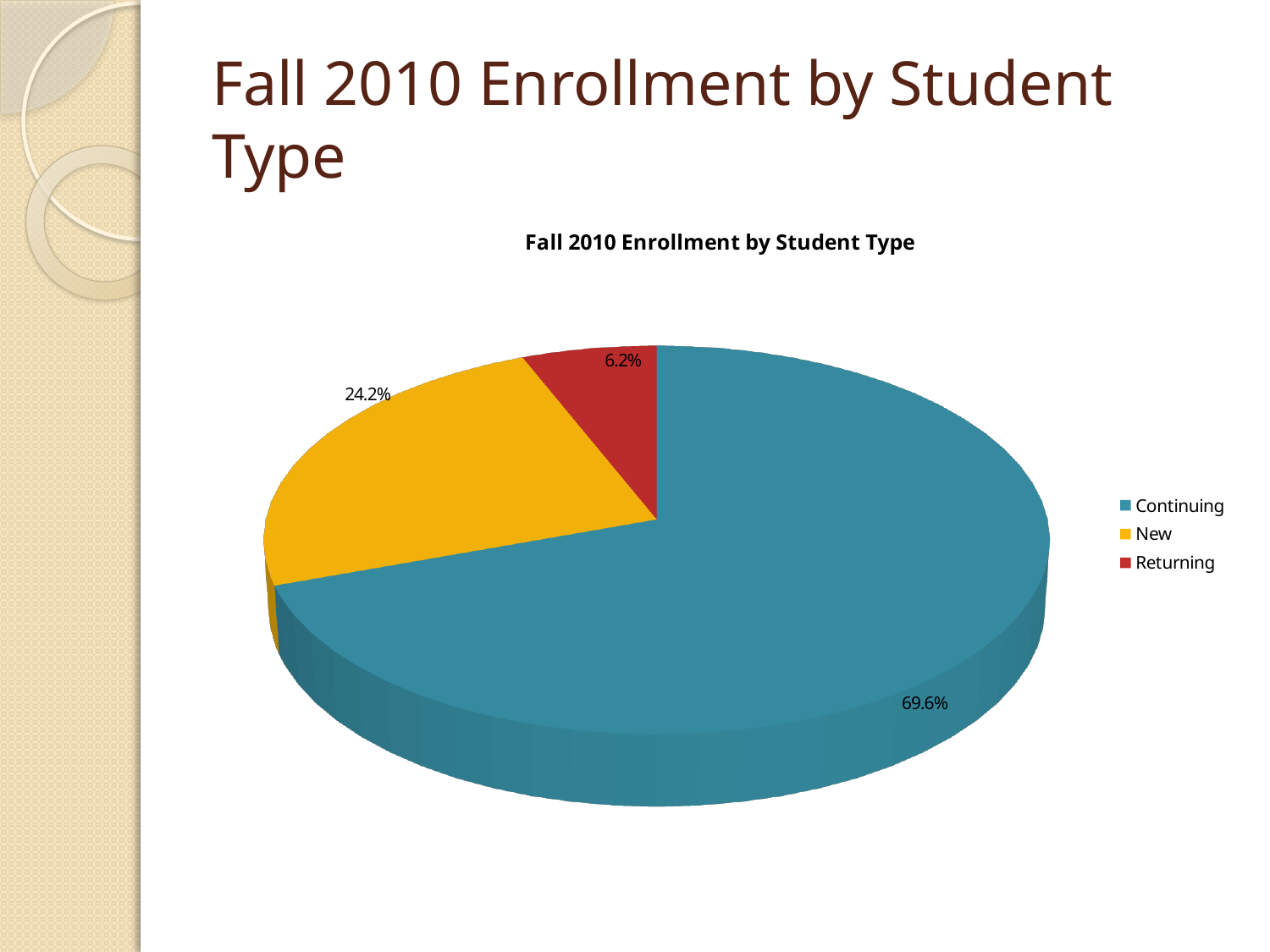
What is the chart's title? Fall 2010 Enrollment by Student Type What share of enrollment is Returning students? 6.2% Which is larger, the share for New students or the share for Returning students? New What kind of chart is shown on the slide? Pie chart What share of enrollment is Continuing students? 69.6% How many student types are shown in the pie chart? 3 How many entries does the legend list? 3 What colour represents Returning students in the pie chart? Red What is the difference in percentage points between the Continuing and New shares? 45.4 Which student type has the largest share of enrollment? Continuing Which student type has the smallest share of enrollment? Returning What share of enrollment is New students? 24.2%